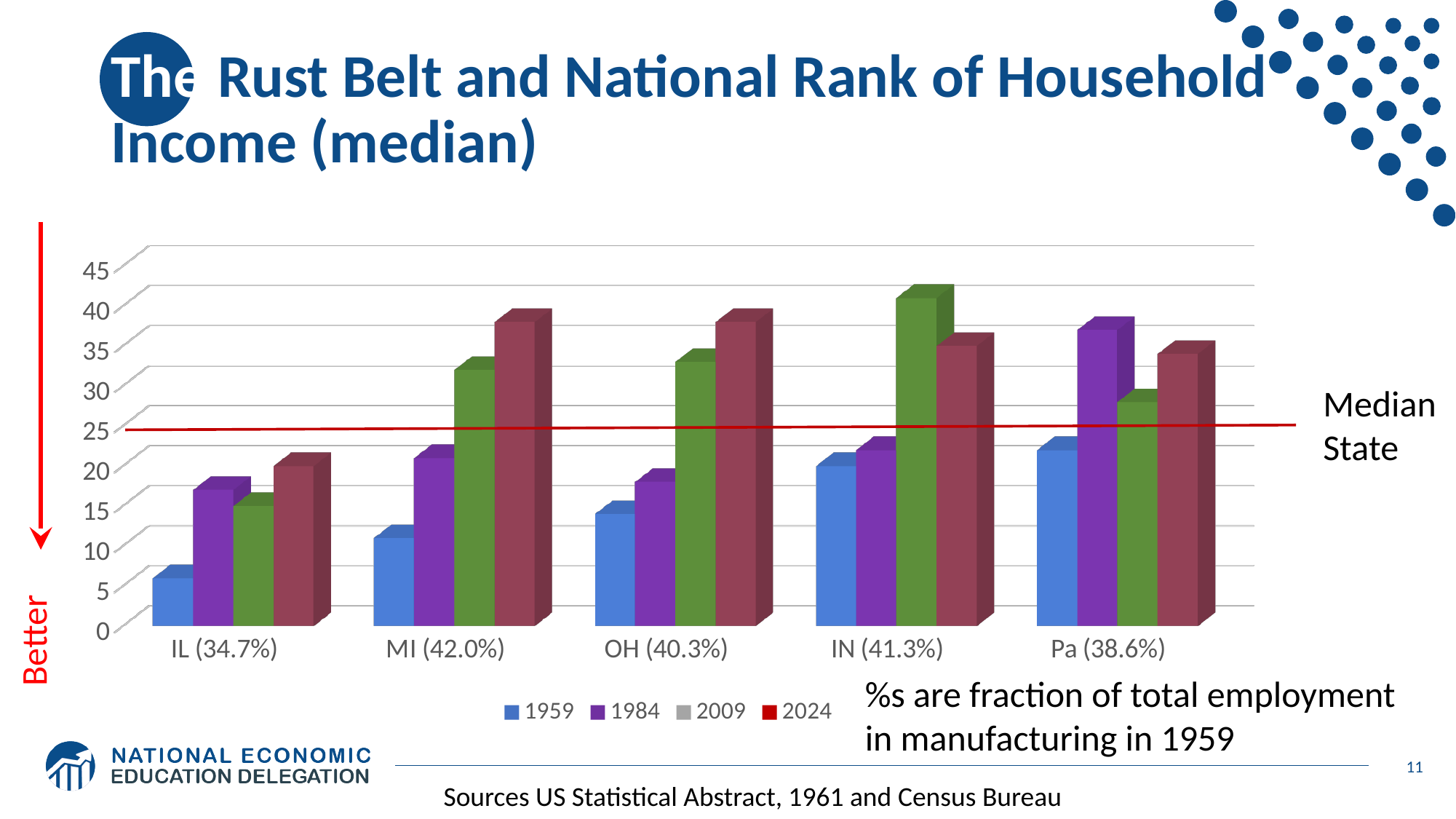
Which state has the lowest value for 1959? IL (34.7%) Which state has the lowest value for 2024? IL (34.7%) Which state has the highest value for 2009? IN (41.3%) Is the 2009 value for IN (41.3%) greater or less than 35? greater How many series does the chart's legend list? 4 Which is larger, the 2024 value for IL (34.7%) or the 2024 value for MI (42.0%)? MI (42.0%) Is the 1959 value for IL (34.7%) greater or less than 10? less What kind of chart is shown on the slide? bar chart How many states (categories) are shown on the x axis of the chart? 5 Is the 2024 value for MI (42.0%) greater or less than 35? greater For Pa (38.6%), which is larger, the 1984 value or the 2009 value? 1984 What does the red horizontal line across the chart represent? Median State